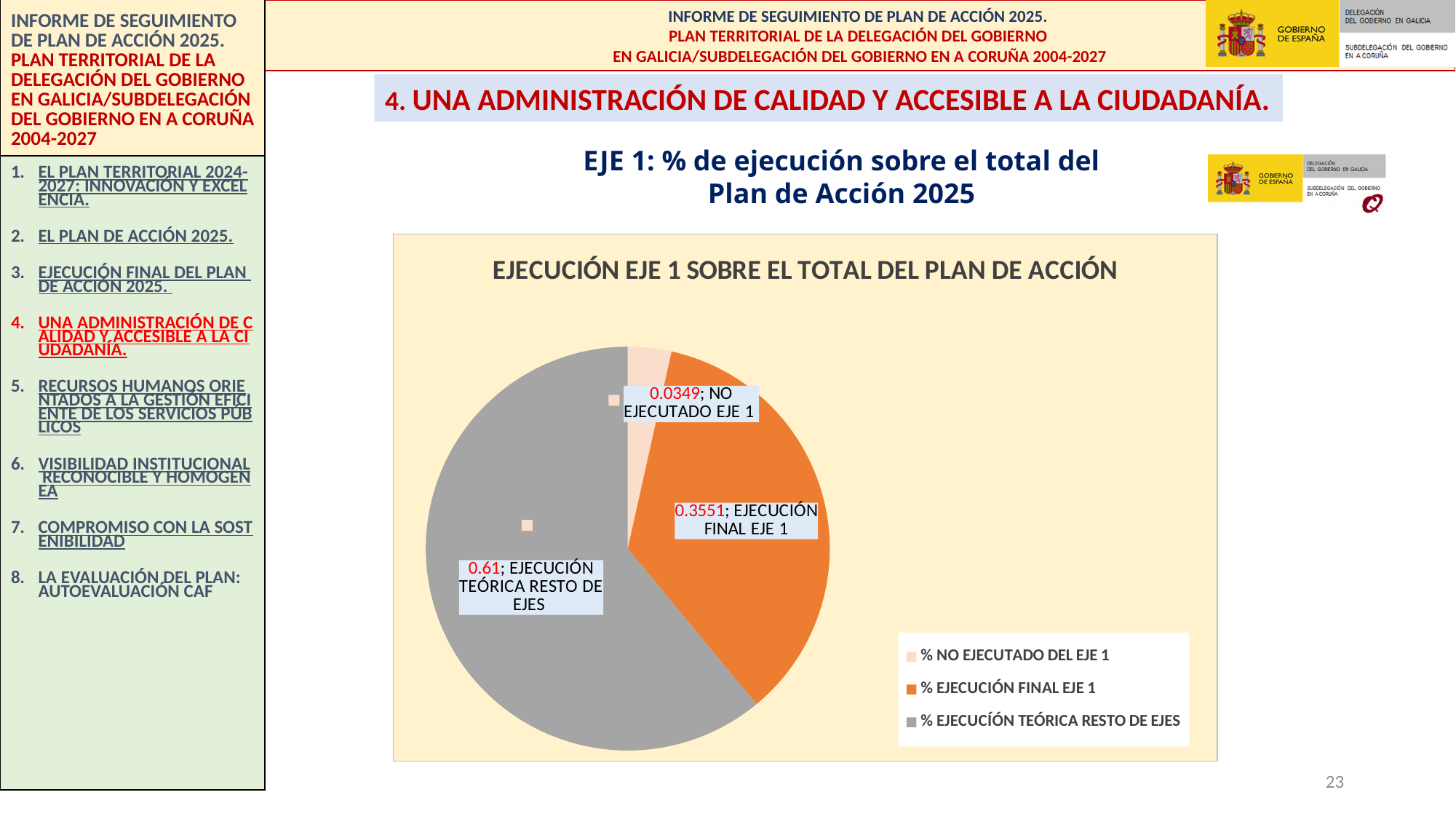
What colour is the slice for EJECUCIÓN FINAL EJE 1? orange What is the title of the chart? EJECUCIÓN EJE 1 SOBRE EL TOTAL DEL PLAN DE ACCIÓN Which slice of the pie is the smallest? NO EJECUTADO EJE 1 What is the value shown for NO EJECUTADO EJE 1? 0.0349 What is the value shown for EJECUCIÓN FINAL EJE 1? 0.3551 What is the value shown for EJECUCIÓN TEÓRICA RESTO DE EJES? 0.61 What is the difference between the values for EJECUCIÓN TEÓRICA RESTO DE EJES and EJECUCIÓN FINAL EJE 1? 0.2549 How many slices does the pie chart have? 3 What kind of chart is shown on the slide? pie chart How many entries does the legend list? 3 Which is larger, EJECUCIÓN FINAL EJE 1 or NO EJECUTADO EJE 1? EJECUCIÓN FINAL EJE 1 Which slice of the pie is the largest? EJECUCIÓN TEÓRICA RESTO DE EJES